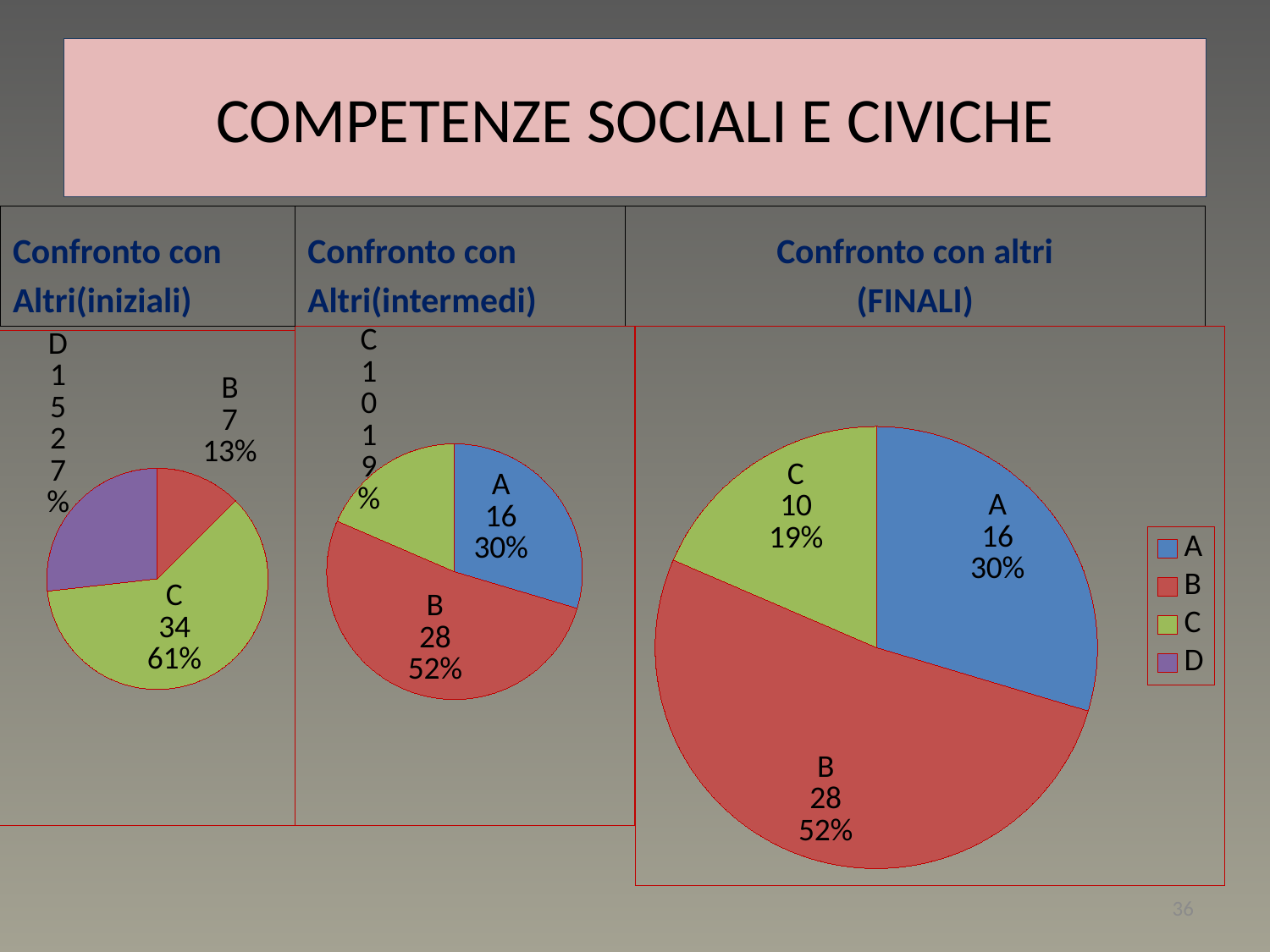
In the 'Confronto con altri (FINALI)' chart, what share of the pie does slice C represent? 19% In the 'Confronto con Altri(iniziali)' chart, what is the value for B? 7 In the 'Confronto con altri (FINALI)' chart, which category has the largest slice? B In the 'Confronto con altri (FINALI)' chart, which category has the smallest slice? C In the 'Confronto con altri (FINALI)' chart, what is the difference between the values for B and A? 12 In the 'Confronto con Altri(intermedi)' chart, which is larger, the value for A or the value for B? B How many entries does the legend on the slide list? 4 In the 'Confronto con altri (FINALI)' chart, what share of the pie does slice A represent? 30% In the 'Confronto con Altri(iniziali)' chart, what share of the pie does slice C represent? 61% In the 'Confronto con altri (FINALI)' chart, what is the value for B? 28 What kind of chart is the 'Confronto con altri (FINALI)' chart? Pie chart In the 'Confronto con Altri(intermedi)' chart, what is the value for C? 10